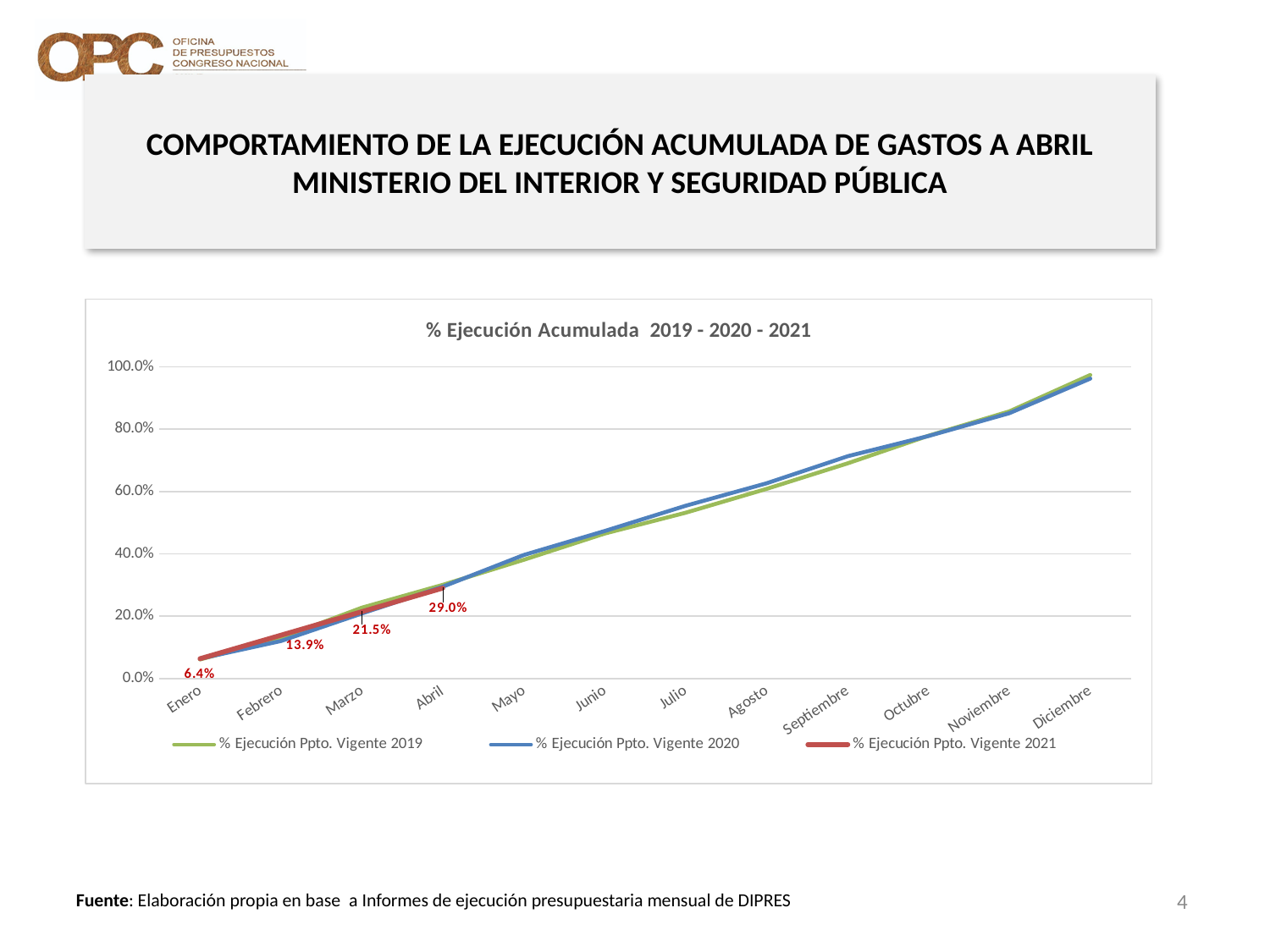
Do the values in the % Ejecución Ppto. Vigente 2020 series rise or fall from Enero to Diciembre? Rise What is the value for Febrero in the % Ejecución Ppto. Vigente 2021 series? 13.9% How many months are shown on the x axis? 12 Is the value for Diciembre in the % Ejecución Ppto. Vigente 2020 series greater or less than 80%? greater What is the title of the chart? % Ejecución Acumulada 2019 - 2020 - 2021 What kind of chart is shown on the slide? Line chart What is the value for Marzo in the % Ejecución Ppto. Vigente 2021 series? 21.5% What is the difference between the Abril and Marzo values in the % Ejecución Ppto. Vigente 2021 series? 7.5% What is the difference between the Abril and Enero values in the % Ejecución Ppto. Vigente 2021 series? 22.6% What is the value for Abril in the % Ejecución Ppto. Vigente 2021 series? 29.0% How many series does the legend list? 3 What is the value for Enero in the % Ejecución Ppto. Vigente 2021 series? 6.4%